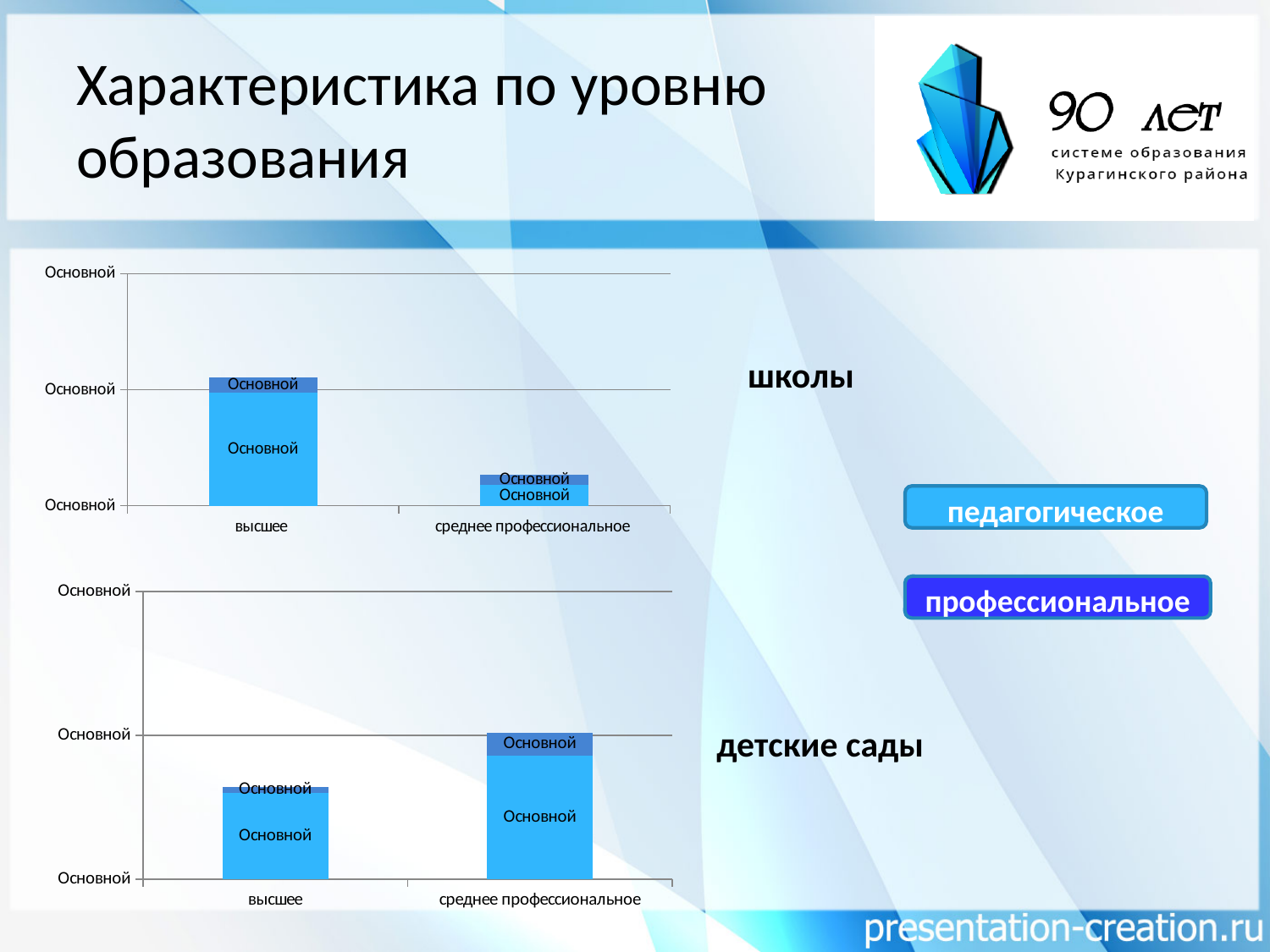
In the bottom chart ("детские сады"), which category has the tallest bar? среднее профессиональное In the bottom chart ("детские сады"), how many categories are shown on the x axis? 2 Which label on the slide is shown in the dark blue box next to the charts? профессиональное What kind of chart is the bottom chart labelled "детские сады"? bar chart In the top chart ("школы"), how many categories are shown on the x axis? 2 What kind of chart is the top chart labelled "школы"? bar chart In the bottom chart ("детские сады"), is the bar for "высшее" taller or shorter than the bar for "среднее профессиональное"? shorter In the top chart ("школы"), is the bar for "высшее" taller or shorter than the bar for "среднее профессиональное"? taller In the bottom chart ("детские сады"), which category has the shortest bar? высшее In the top chart ("школы"), which category has the tallest bar? высшее In the top chart ("школы"), which category has the shortest bar? среднее профессиональное What are the names of the two categories on the x axis of the bottom chart ("детские сады")? высшее, среднее профессиональное